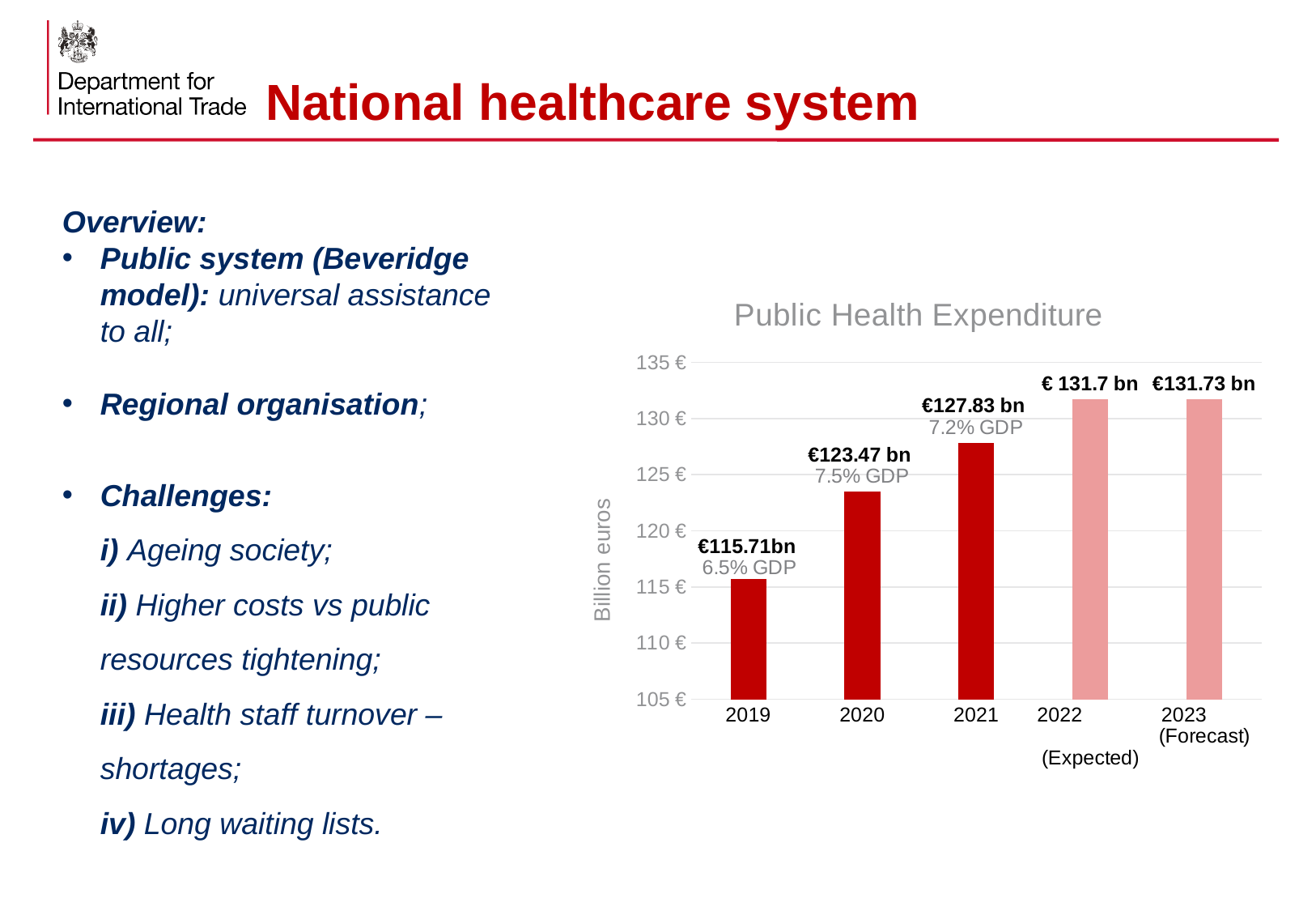
Is the value for 2019 greater or less than 120 €? less What is the difference in public health expenditure between 2020 and 2019? €7.76 bn How many years are shown on the x axis of the chart? 5 Do the public health expenditure values rise or fall from 2019 to 2023? Rise What is the public health expenditure value shown for 2021? €127.83 bn What is the title of the chart? Public Health Expenditure What is the public health expenditure value shown for 2019? €115.71bn Which year has the lowest public health expenditure? 2019 Which year has the larger public health expenditure, 2020 or 2021? 2021 What type of chart is shown on the slide? Bar chart What is the forecast public health expenditure value for 2023? €131.73 bn What percentage of GDP is shown for public health expenditure in 2020? 7.5% GDP